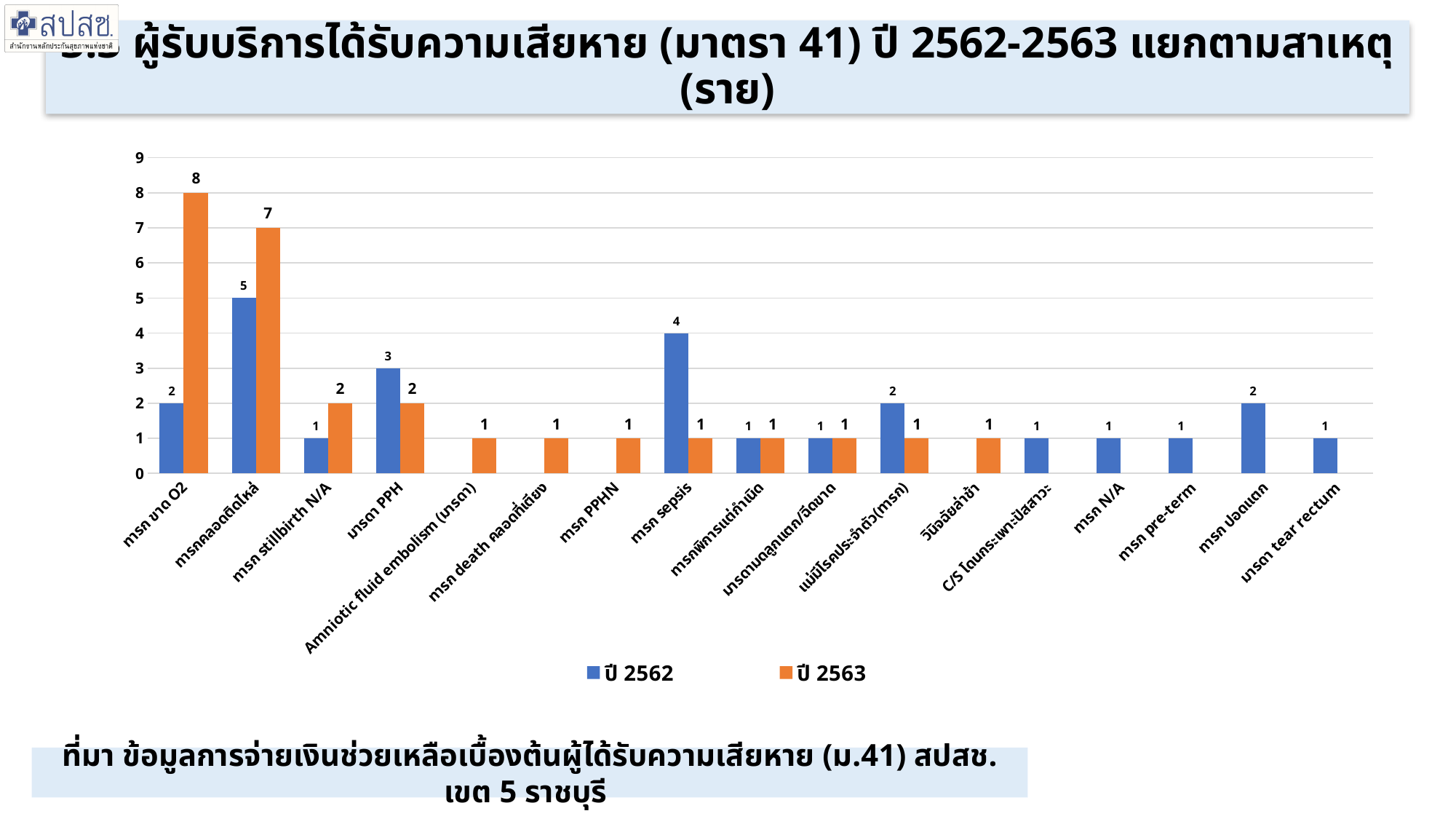
What is the difference between the ปี 2563 and ปี 2562 values for ทารก ขาด O2? 6 What kind of chart is shown on the slide? Bar chart For ทารก sepsis, which series has the larger value, ปี 2562 or ปี 2563? ปี 2562 Which category has the highest value in the ปี 2563 series? ทารก ขาด O2 For ทารก stillbirth N/A, which series has the larger value, ปี 2562 or ปี 2563? ปี 2563 What is the value for มารดา PPH in the ปี 2562 series? 3 How many series does the legend list? 2 What is the value for ทารก ขาด O2 in the ปี 2563 series? 8 How many categories are shown on the x axis? 17 What is the difference between the ปี 2563 and ปี 2562 values for ทารกคลอดติดไหล่? 2 What is the value for ทารก sepsis in the ปี 2562 series? 4 Which category has the highest value in the ปี 2562 series? ทารกคลอดติดไหล่